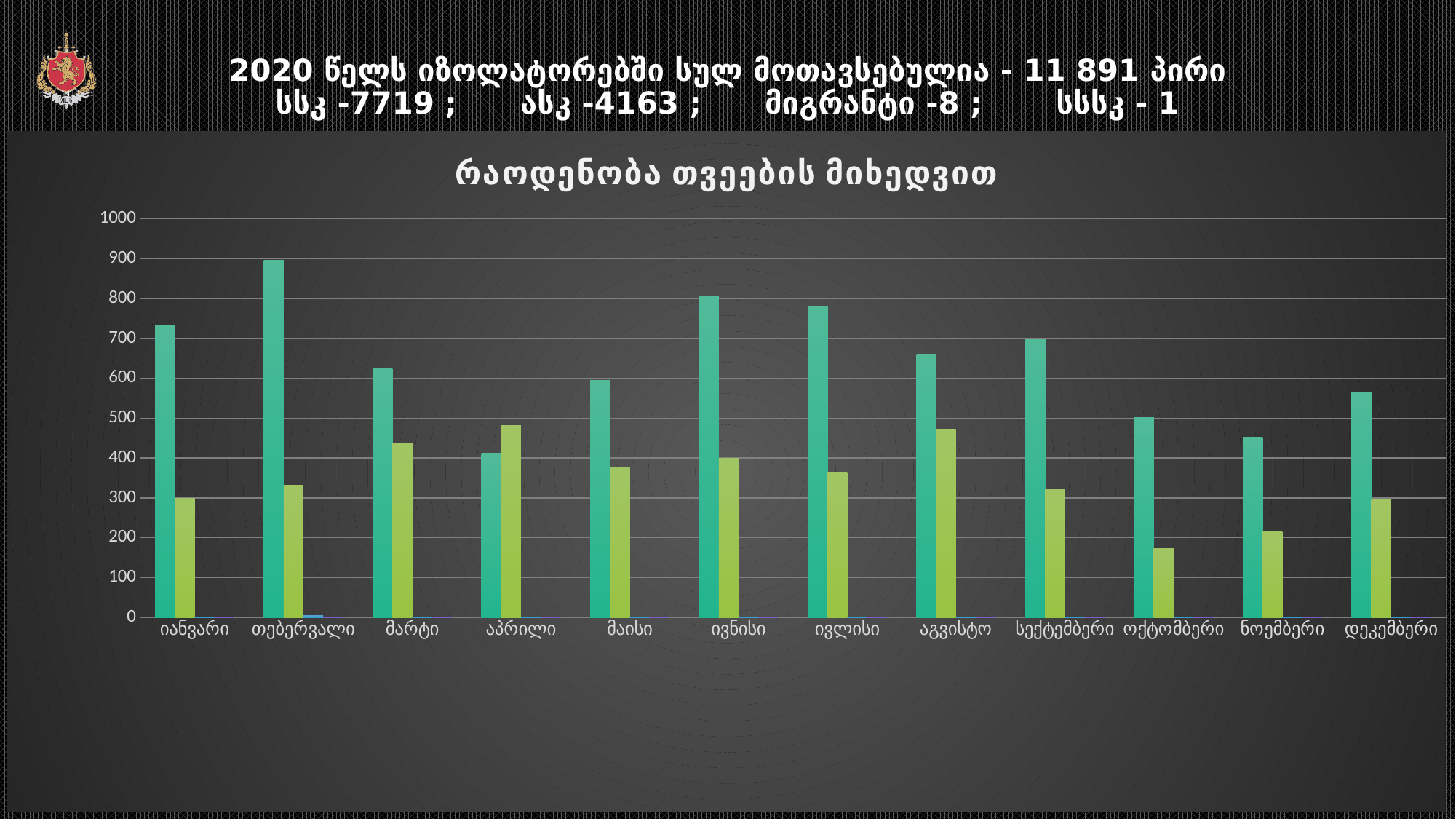
Is the green bar for ოქტომბერი greater or less than 200? less Is the teal bar for აპრილი greater or less than 500? less Is the teal bar for თებერვალი greater or less than 800? greater What is the title of the chart? რაოდენობა თვეების მიხედვით How many months (categories) are shown on the x axis of the chart? 12 Which is larger: the teal bar for იანვარი or the teal bar for მარტი? იანვარი Do the teal bars rise or fall from სექტემბერი to ნოემბერი? fall What kind of chart is shown on the slide? bar chart For the green (second) bars, which month has the lowest value? ოქტომბერი For the teal (first) bars, which month has the highest value? თებერვალი For the teal (first) bars, which month has the lowest value? აპრილი